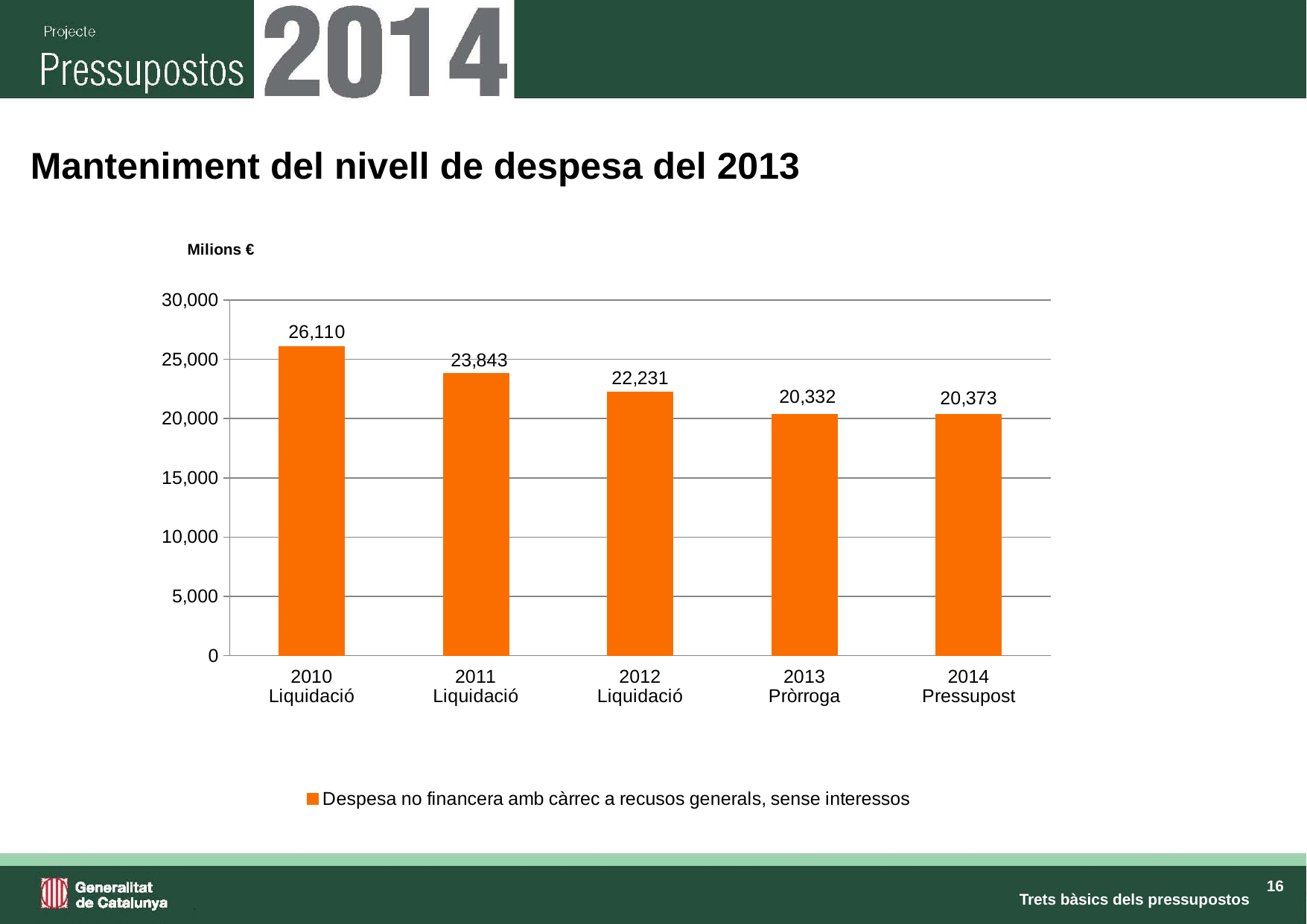
Which is larger, the value for 2011 Liquidació or 2012 Liquidació? 2011 Liquidació What is the value for 2014 Pressupost? 20,373 What is the value for 2013 Pròrroga? 20,332 What is the difference between the values for 2010 Liquidació and 2011 Liquidació? 2,267 What is the value for 2010 Liquidació? 26,110 Which category has the lowest value? 2013 Pròrroga Which category has the highest value? 2010 Liquidació Is the value for 2012 Liquidació greater or less than 20,000? greater Do the values rise or fall from 2010 Liquidació to 2013 Pròrroga? fall How many categories are shown on the x axis? 5 What is the difference between the values for 2014 Pressupost and 2013 Pròrroga? 41 What kind of chart is shown on the slide? bar chart